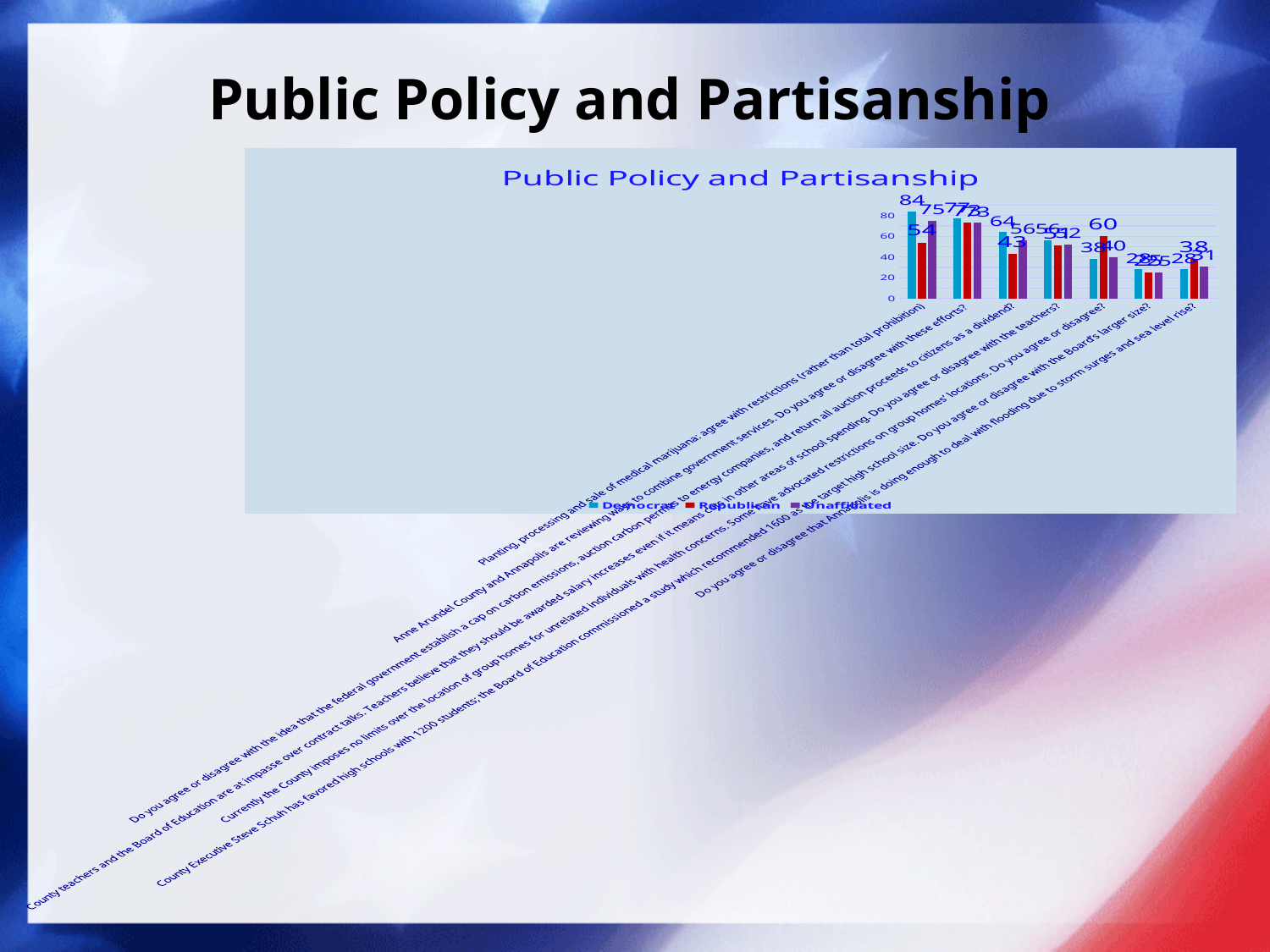
What is the title of the chart? Public Policy and Partisanship How many category groups of bars are plotted in the chart? 7 What is the Democrat value for the first (leftmost) category group? 84 Is the Republican value in the first (leftmost) category group greater or less than 60? less What is the Democrat value for the last (rightmost) category group? 28 What kind of chart is shown on the slide? bar chart What is the highest value plotted anywhere in the chart? 84 In the first (leftmost) category group, which is larger, the Democrat value or the Republican value? Democrat What is the difference between the Democrat and Republican values in the first (leftmost) category group? 30 How many series does the chart's legend list? 3 What is the Republican value for the first (leftmost) category group? 54 Which series are listed in the chart's legend? Democrat, Republican, Unaffiliated